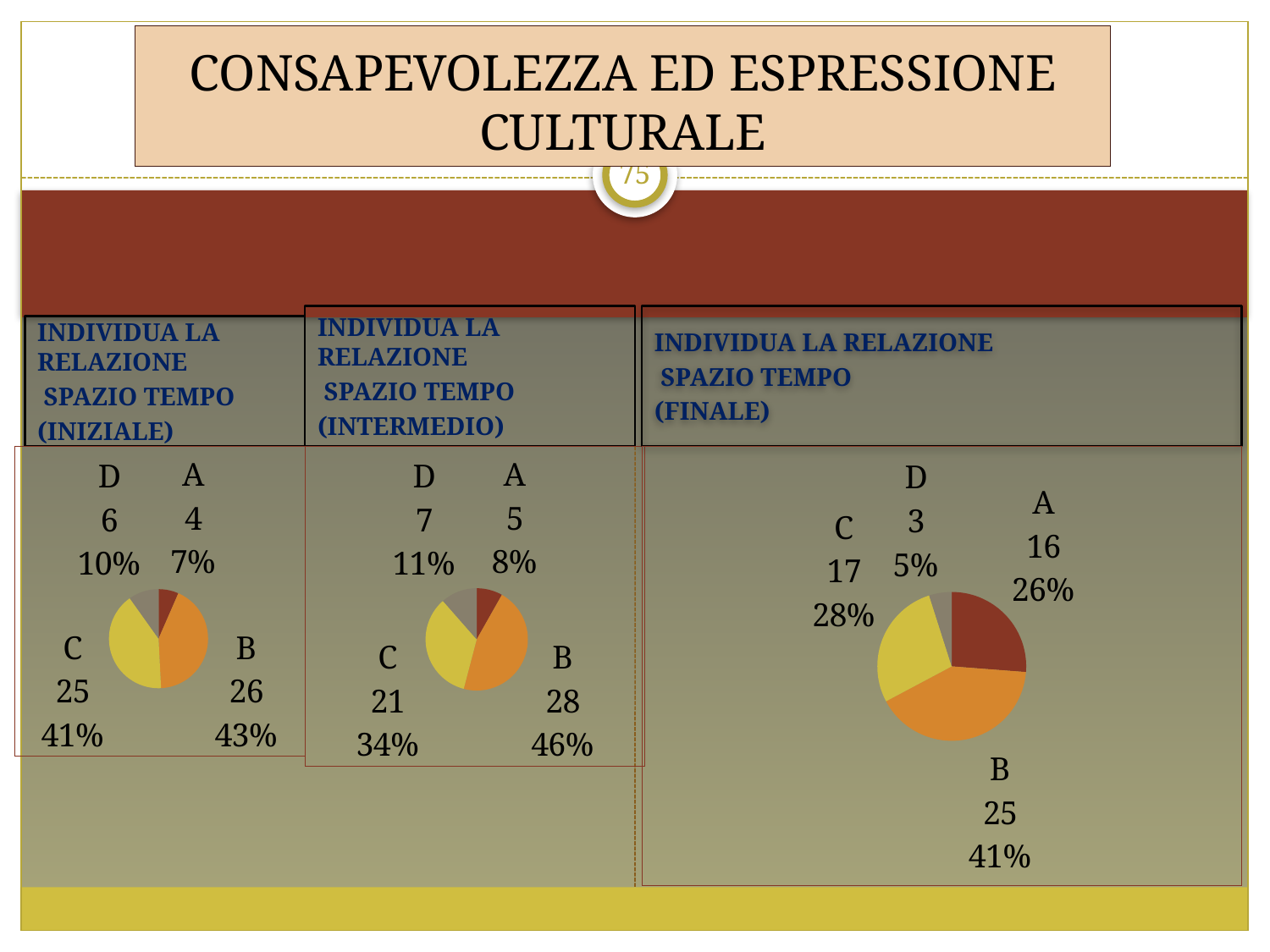
In the INTERMEDIO pie chart, what is the value for category D? 7 In the INIZIALE pie chart, which category has the lowest value? A How many categories does the INIZIALE pie chart show? 4 What type of chart is used in the FINALE panel? Pie chart In the FINALE pie chart, what is the difference between the values for B and A? 9 In the FINALE pie chart, which is larger, the value for A or the value for D? A In the INIZIALE pie chart, what is the value for category B? 26 In the INIZIALE pie chart, what percentage share does category C have? 41% In the INTERMEDIO pie chart, which category has the highest value? B In the FINALE pie chart, what percentage share does category A have? 26% In the INTERMEDIO pie chart, what is the difference between the values for B and C? 7 In the FINALE pie chart, what is the value for category C? 17